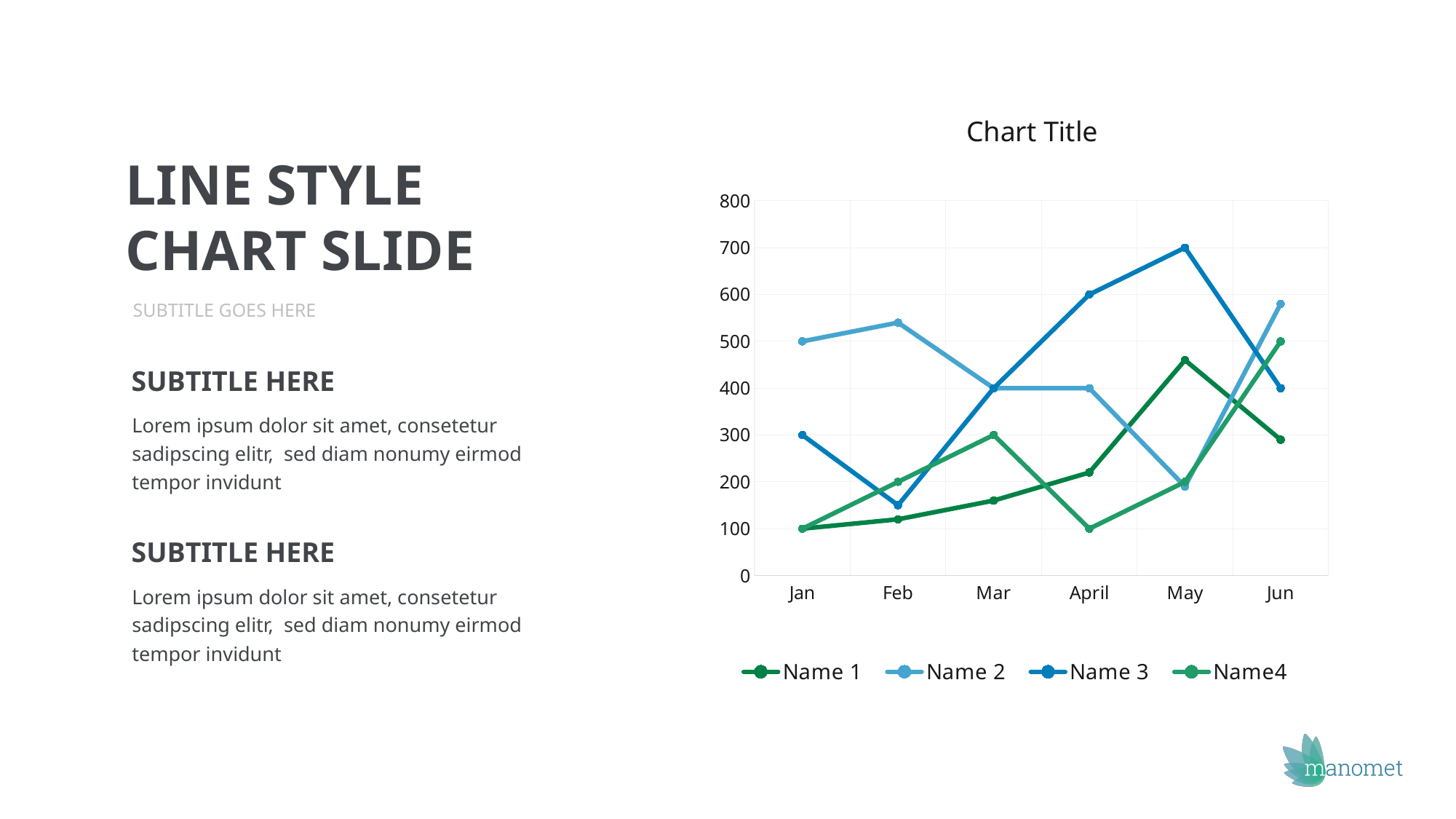
Does the Name 3 line rise or fall from Feb to May? Rise In which month does Name 3 have its lowest value? Feb How many series does the legend list? 4 What is the value for Name 3 in May? 700 Is the value for Name 1 in May greater or less than 400? greater What type of chart is shown on the slide? Line chart What is the difference between the Name 3 value in May and the Name 3 value in Jan? 400 How many categories are shown on the x axis? 6 Which series has the larger value in May, Name 3 or Name 2? Name 3 In which month does Name 3 reach its highest value? May What is the value for Name4 in Jun? 500 What is the value for Name 2 in Jan? 500